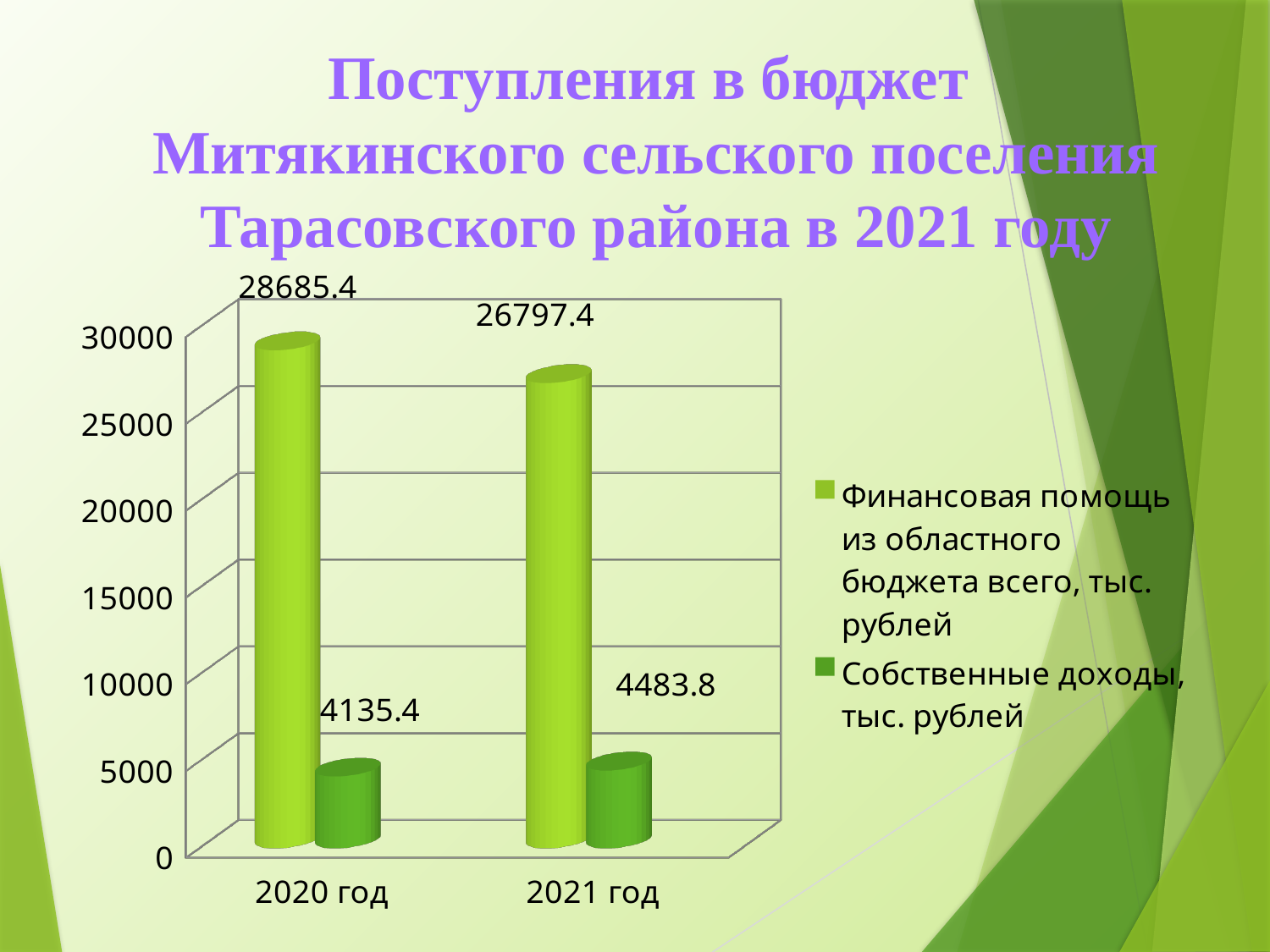
What is the value of 'Собственные доходы, тыс. рублей' for 2021 год? 4483.8 What kind of chart is shown on the slide? Bar chart In which year is 'Собственные доходы' lower? 2020 год Which is larger in 2021 год: 'Финансовая помощь из областного бюджета всего' or 'Собственные доходы'? Финансовая помощь из областного бюджета всего By how much did 'Финансовая помощь из областного бюджета всего' decrease from 2020 год to 2021 год? 1888.0 In which year is 'Финансовая помощь из областного бюджета всего' higher? 2020 год How many series does the legend list? 2 What is the value of 'Финансовая помощь из областного бюджета всего, тыс. рублей' for 2021 год? 26797.4 What is the value of 'Финансовая помощь из областного бюджета всего, тыс. рублей' for 2020 год? 28685.4 What is the value of 'Собственные доходы, тыс. рублей' for 2020 год? 4135.4 What is the difference between 'Собственные доходы' in 2021 год and 2020 год? 348.4 How many categories are shown on the x axis? 2